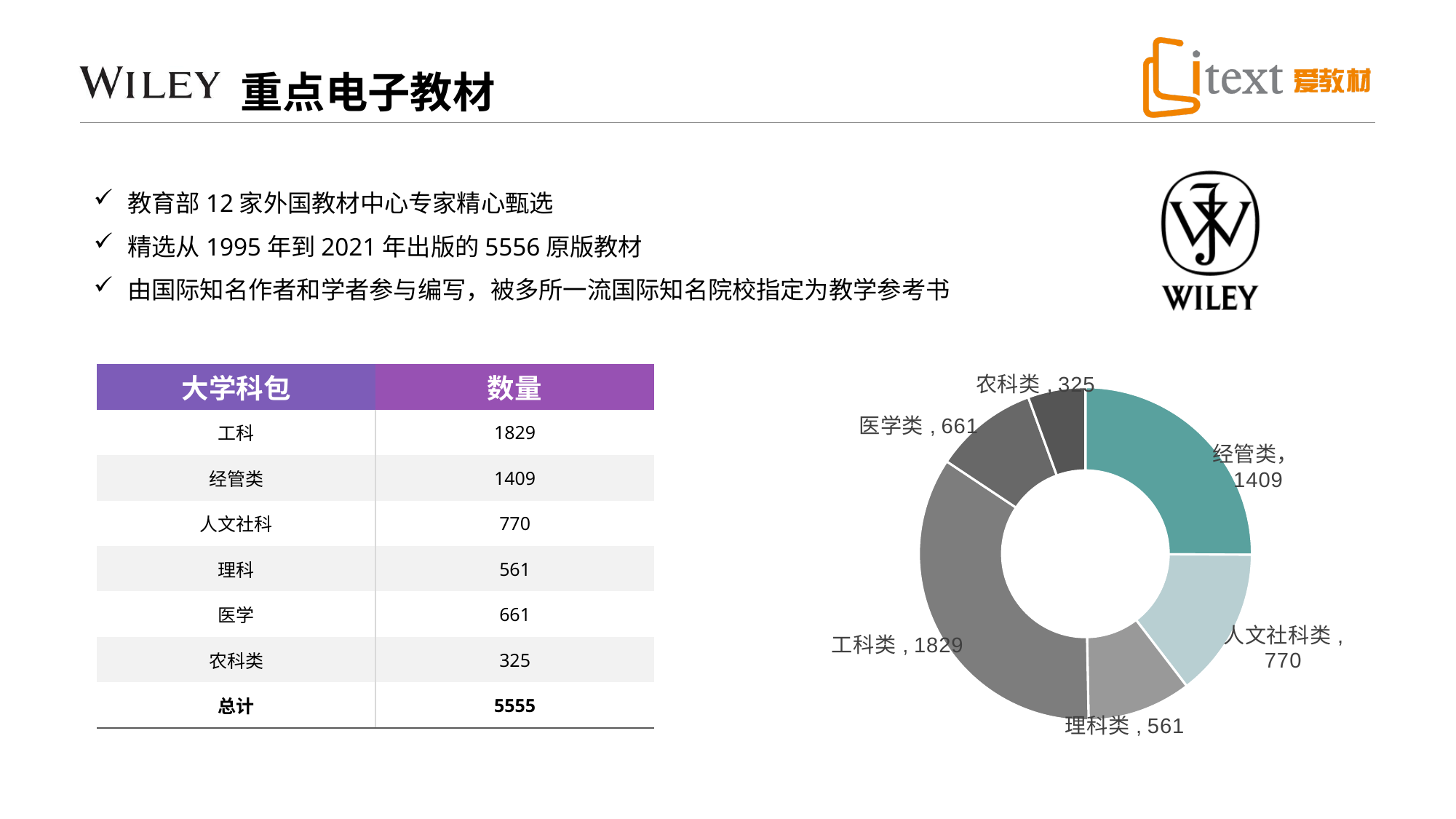
What is the value for 工科类 in the doughnut chart? 1829 Which category has the largest slice in the doughnut chart? 工科类 What is the difference between the values for 工科类 and 经管类? 420 Which slice of the doughnut chart is coloured teal? 经管类 Which is larger, the value for 人文社科类 or the value for 医学类? 人文社科类 What is the value for 医学类 in the doughnut chart? 661 What is the total of all the values shown in the doughnut chart? 5555 What is the value for 农科类 in the doughnut chart? 325 What is the value for 经管类 in the doughnut chart? 1409 Which category has the smallest slice in the doughnut chart? 农科类 What type of chart is shown on the slide? Doughnut chart How many categories does the doughnut chart show? 6